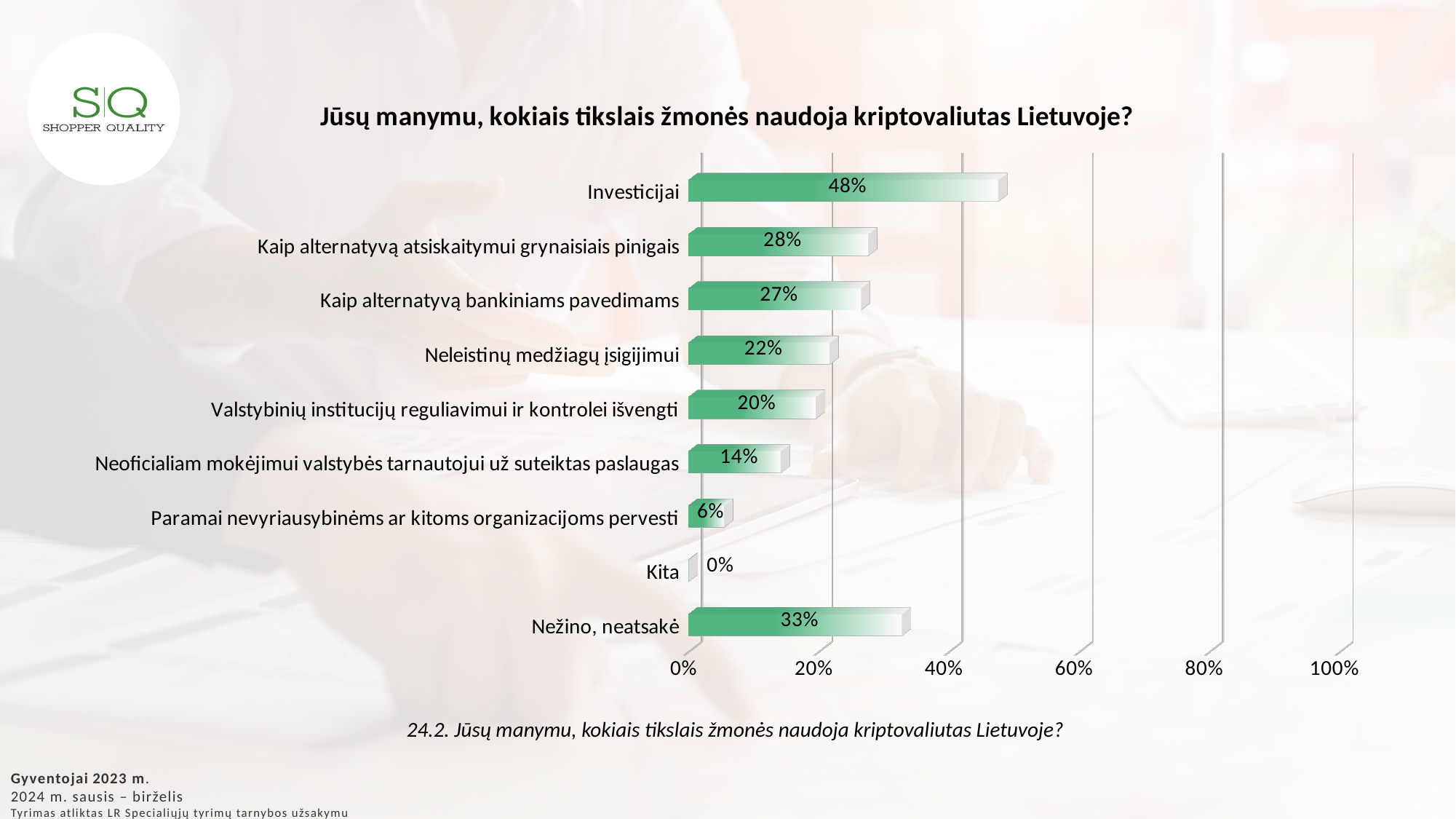
How many categories are shown in the chart? 9 What is the value for Paramai nevyriausybinėms ar kitoms organizacijoms pervesti? 6% Is the value for Nežino, neatsakė greater or less than 40%? less Which is larger: Valstybinių institucijų reguliavimui ir kontrolei išvengti or Neoficialiam mokėjimui valstybės tarnautojui už suteiktas paslaugas? Valstybinių institucijų reguliavimui ir kontrolei išvengti What is the value for Neleistinų medžiagų įsigijimui? 22% Which category has the highest value? Investicijai What is the title of the chart? Jūsų manymu, kokiais tikslais žmonės naudoja kriptovaliutas Lietuvoje? What is the value for Nežino, neatsakė? 33% What is the value for Investicijai? 48% Which category has the lowest value? Kita What is the difference between Investicijai and Kaip alternatyva atsiskaitymui grynaisiais pinigais? 20% What kind of chart is shown on the slide? bar chart